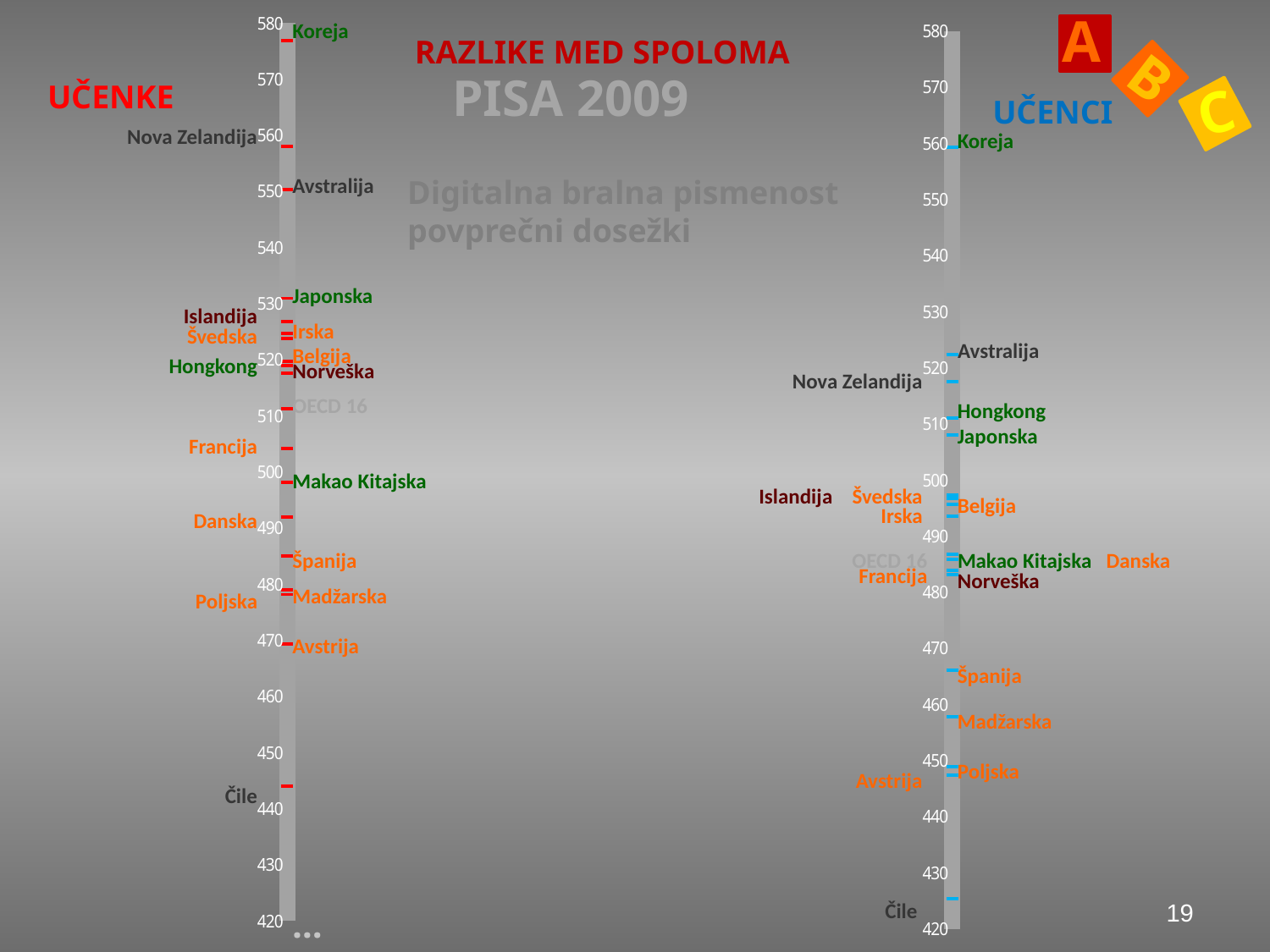
On the UČENCI chart, is the value for Koreja greater or less than 550? greater On the UČENCI chart, which country has the lowest value? Čile On the UČENKE chart, which country has the highest value? Koreja On the UČENKE chart, which country has the lowest value? Čile What is the main title shown on the slide above the charts? RAZLIKE MED SPOLOMA PISA 2009 On the UČENKE chart, which is higher, Nova Zelandija or Avstralija? Nova Zelandija On the UČENCI chart, which is higher, Avstralija or Nova Zelandija? Avstralija On the UČENCI chart, which country has the highest value? Koreja What are the lowest and highest values shown on the vertical scale of the UČENKE chart? 420 and 580 On the UČENCI chart, is the value for Poljska greater or less than 460? less On the UČENKE chart, is the value for Koreja greater or less than 570? greater